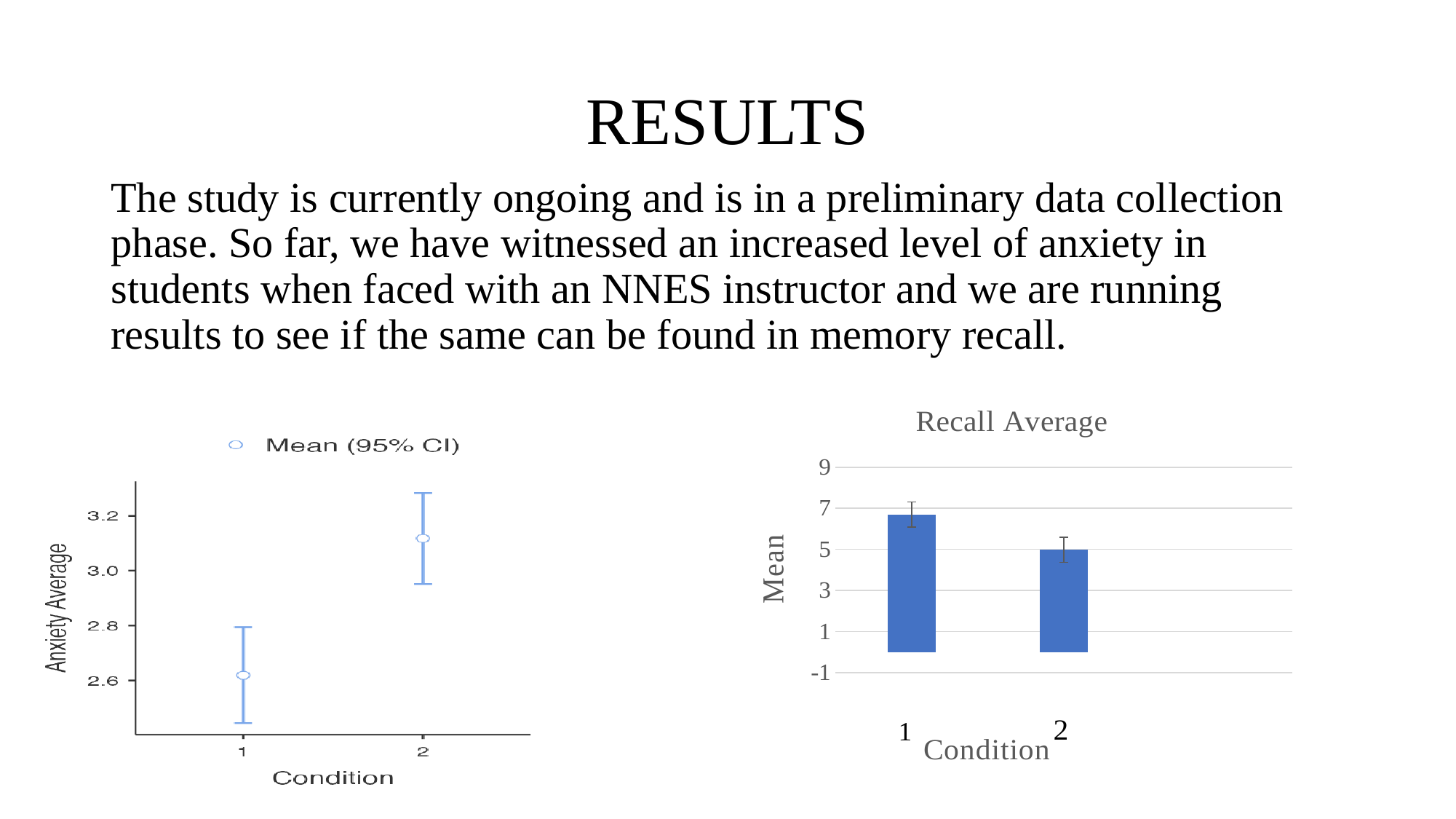
In the Anxiety Average chart on the left, is the mean for condition 1 greater or less than 2.8? less How many bars are plotted in the Recall Average chart? 2 What kind of chart is the Recall Average chart on the right of the slide? bar chart What does the legend of the Anxiety Average chart on the left say? Mean (95% CI) In the Recall Average chart, is the mean for condition 1 greater or less than 5? greater In the Anxiety Average chart on the left, is the mean for condition 2 greater or less than 3.0? greater In the Anxiety Average chart on the left, which condition has the higher anxiety average? 2 In the Recall Average chart, which condition has the higher mean? 1 In the Recall Average chart, does the mean rise or fall from condition 1 to condition 2? fall In the Recall Average chart, which condition has the lower mean? 2